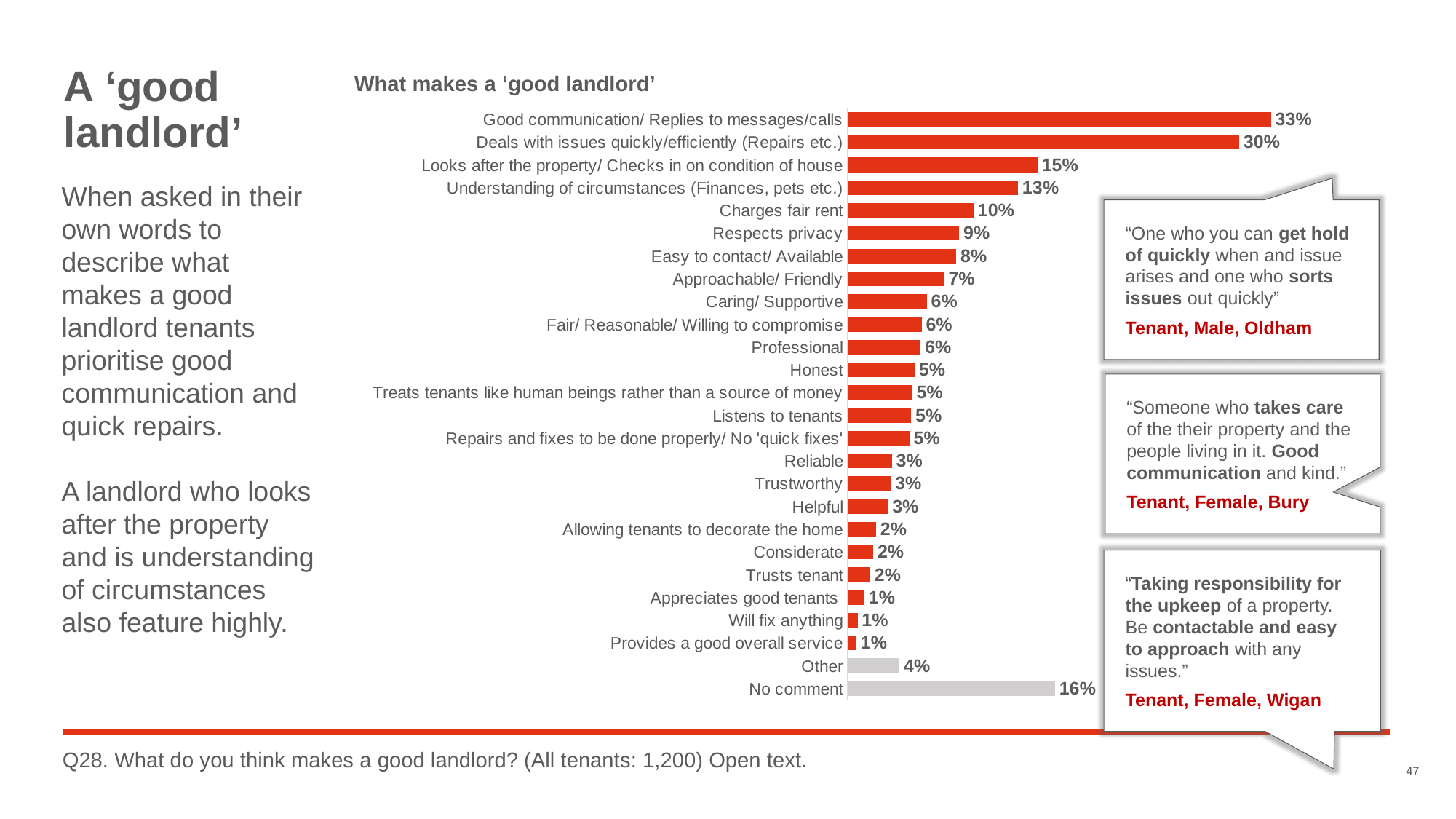
What percentage is shown for 'No comment'? 16% What percentage of tenants said 'Good communication/ Replies to messages/calls' makes a good landlord? 33% What is the difference between 'Good communication/ Replies to messages/calls' and 'Deals with issues quickly/efficiently (Repairs etc.)'? 3% What type of chart is shown on the slide? Bar chart What is the title of the chart? What makes a 'good landlord' What is the value shown for 'Charges fair rent'? 10% What is the value for 'Understanding of circumstances (Finances, pets etc.)'? 13% How many categories are shown in the chart? 26 Which is larger: the value for 'Other' or the value for 'Reliable'? Other Which category has the highest value in the chart? Good communication/ Replies to messages/calls Which is larger: the value for 'Respects privacy' or the value for 'Approachable/ Friendly'? Respects privacy What is the difference between 'Looks after the property/ Checks in on condition of house' and 'Charges fair rent'? 5%